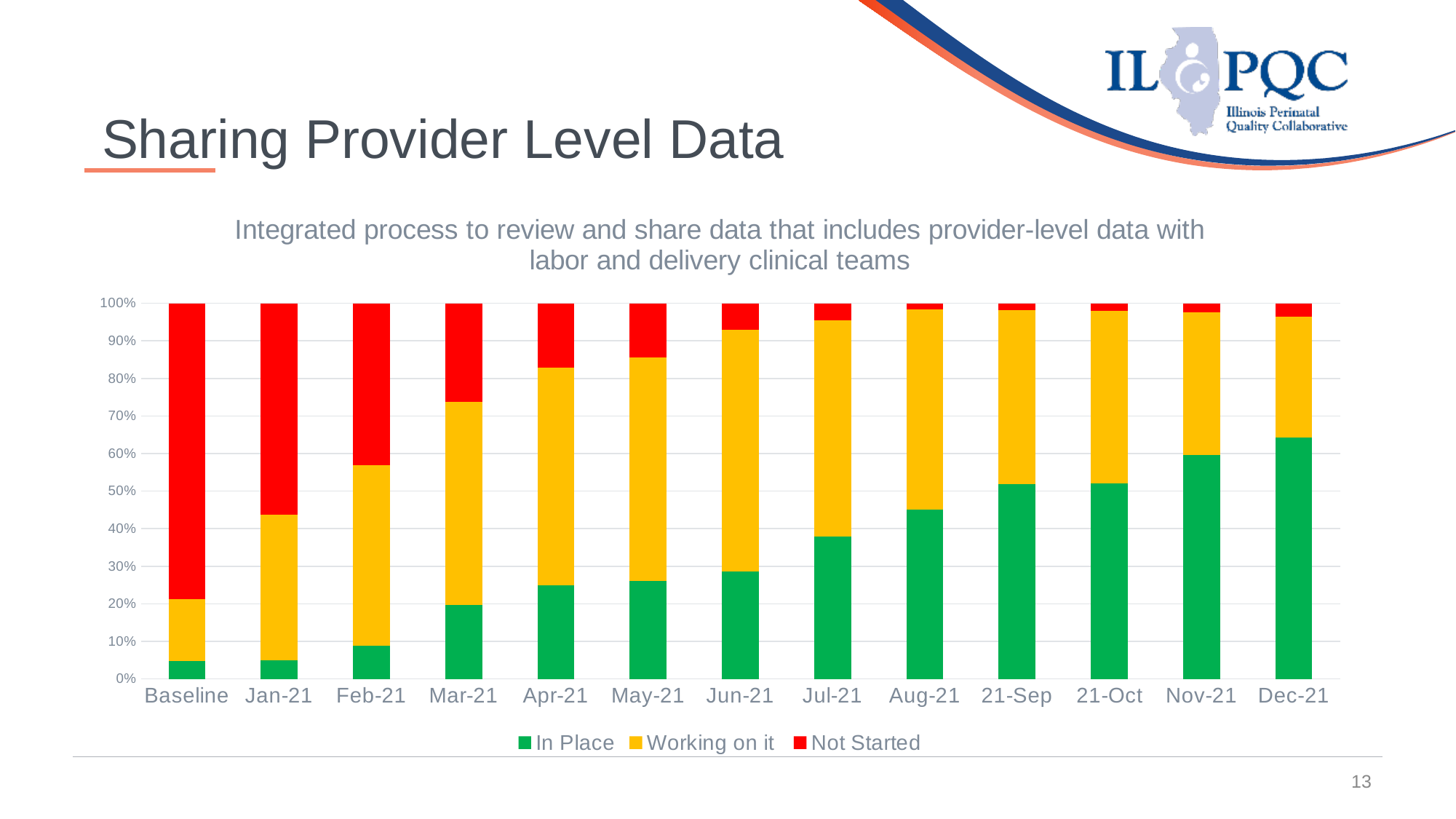
What colour represents the Not Started series? Red How many series does the legend list? 3 Is the In Place value for Jul-21 greater or less than 30%? greater Which is larger, the Not Started share for Jan-21 or for Jun-21? Jan-21 How many categories are shown along the x axis? 13 Which category has the highest Not Started share? Baseline Is the In Place value for Dec-21 greater or less than 60%? greater Does the In Place share rise or fall from Baseline to Dec-21? Rise Is the In Place value for Baseline greater or less than 10%? less Which category has the highest In Place share? Dec-21 What kind of chart is shown on the slide? Stacked bar chart